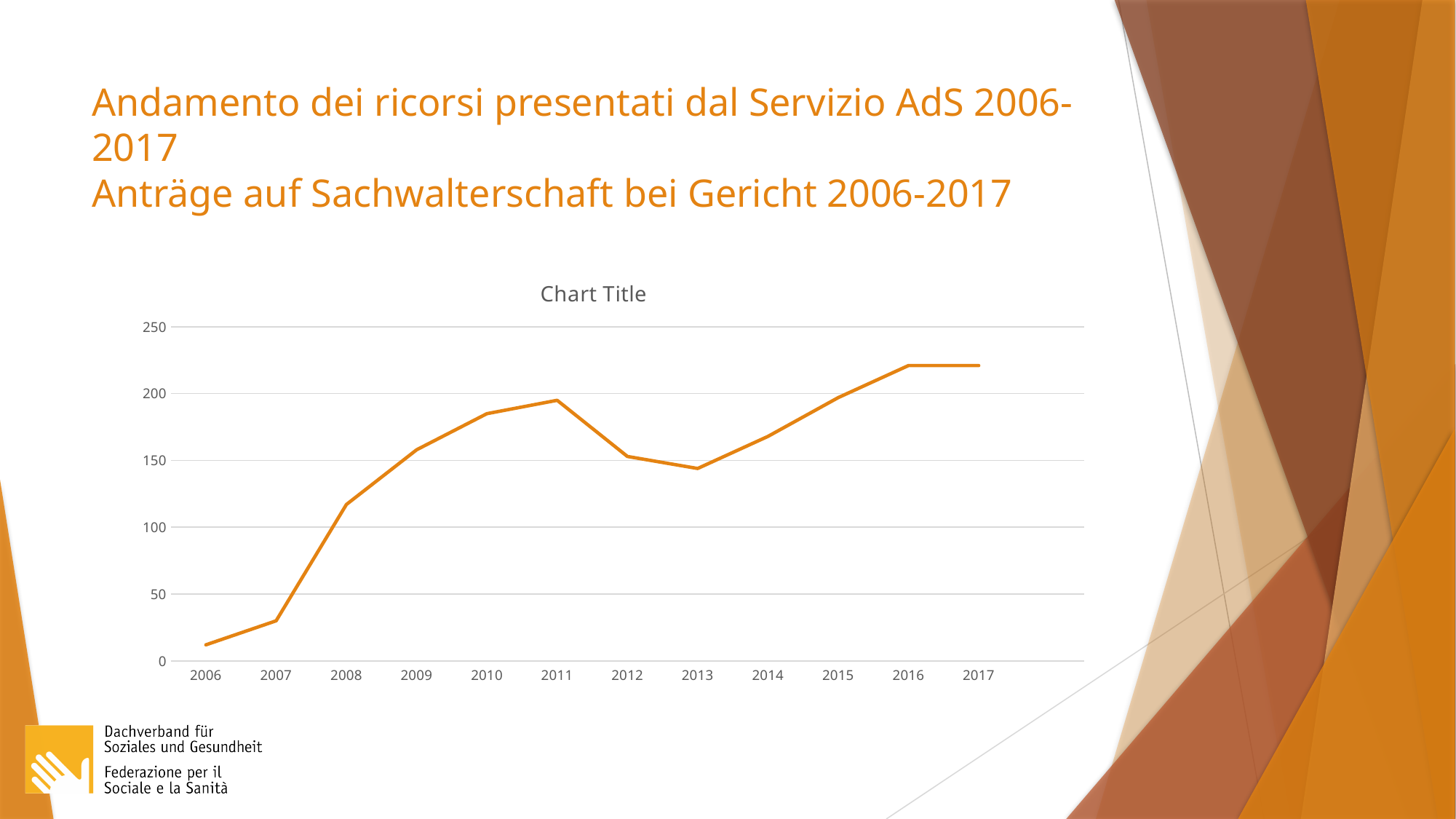
Is the value for 2016 greater or less than 200? greater Which year has the lowest value on the chart? 2006 Is the value for 2008 greater or less than 100? greater Do the values rise or fall from 2011 to 2013? fall Is the value for 2006 greater or less than 50? less Which year has the larger value, 2008 or 2014? 2014 Which year has the larger value, 2011 or 2013? 2011 What kind of chart is shown on the slide? line chart How many years are plotted along the x axis of the chart? 12 What is the title printed above the chart? Chart Title